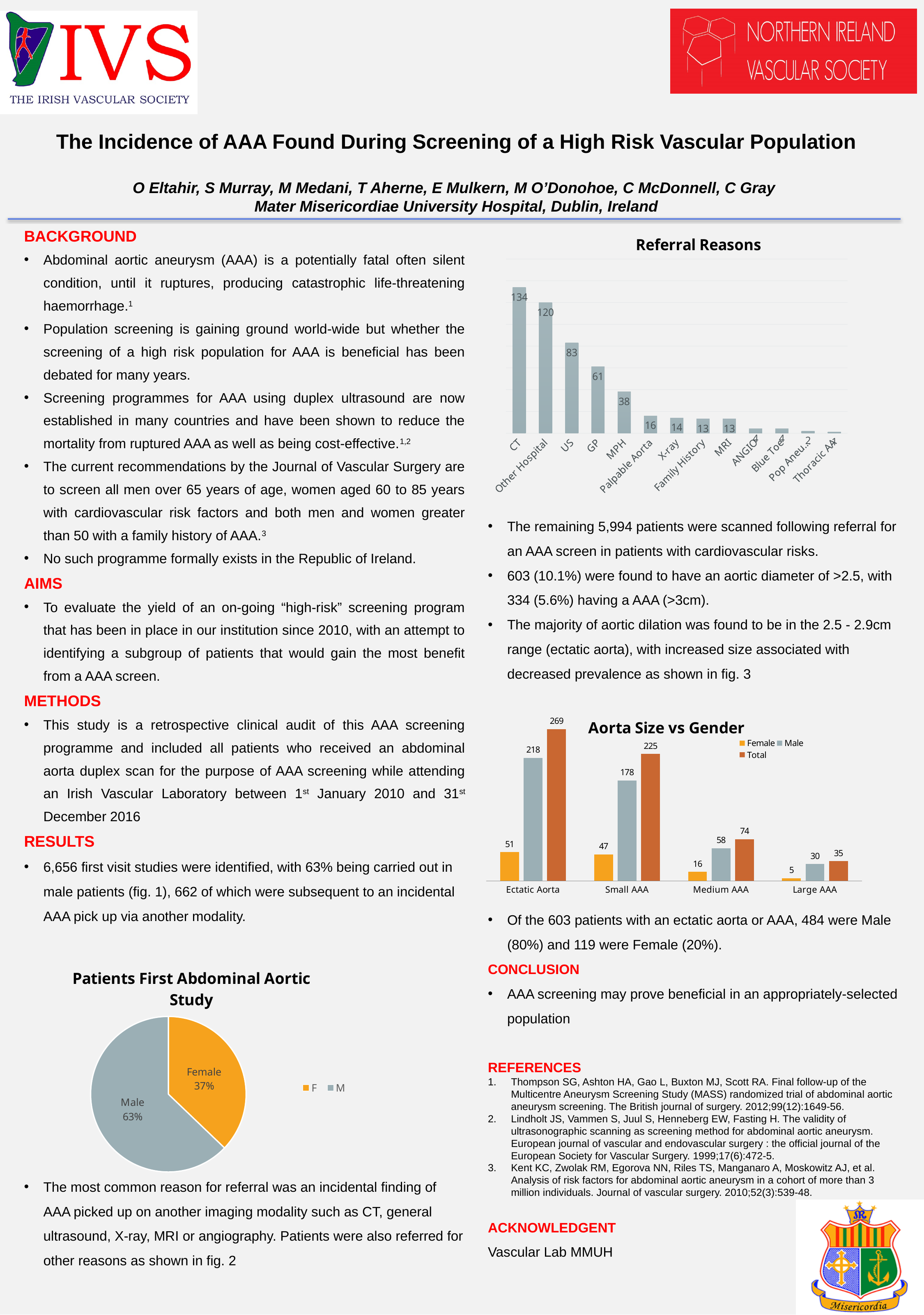
In the Aorta Size vs Gender chart, what is the Total value for Ectatic Aorta? 269 In the Aorta Size vs Gender chart, which category has the lowest Female value? Large AAA In the Referral Reasons chart, which referral reason has the highest value? CT In the Referral Reasons chart, what is the difference between the values for Other Hospital and US? 37 What kind of chart is the Patients First Abdominal Aortic Study chart? pie chart In the Aorta Size vs Gender chart, how many series does the legend list? 3 In the Patients First Abdominal Aortic Study pie chart, what share of patients are Male? 63% In the Referral Reasons chart, do the values rise or fall from left to right along the x axis? fall In the Referral Reasons chart, which is larger, the value for GP or the value for MPH? GP In the Aorta Size vs Gender chart, what is the Male value for Small AAA? 178 In the Referral Reasons chart, how many referral reason categories are shown? 13 In the Referral Reasons chart, what is the value for CT? 134